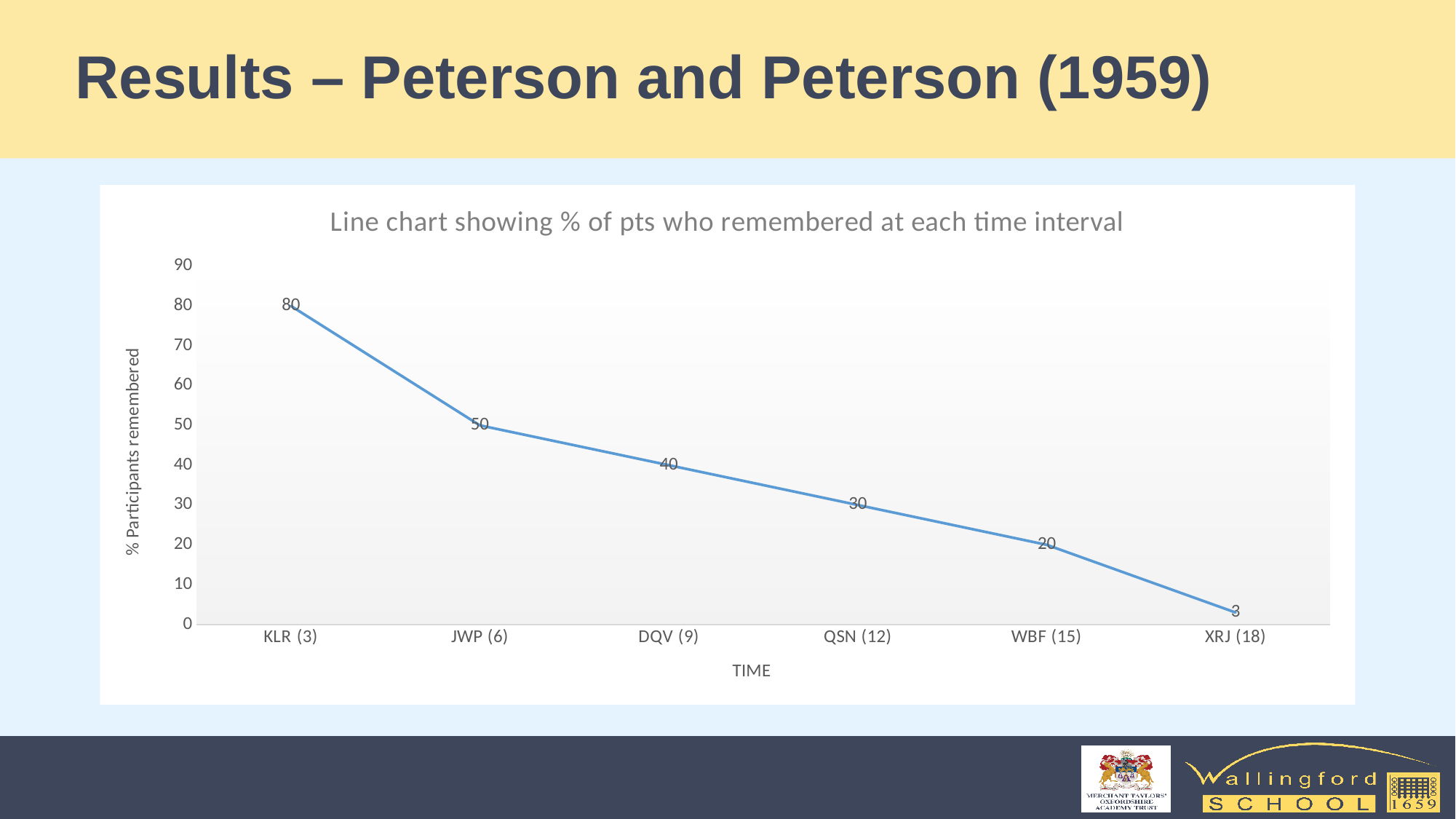
What is the difference between the values for WBF (15) and XRJ (18)? 17 What is the value for DQV (9)? 40 What is the value for KLR (3)? 80 What is the title of the chart? Line chart showing % of pts who remembered at each time interval What is the value for XRJ (18)? 3 Which time interval has the highest % of participants remembered? KLR (3) How many time intervals are plotted on the chart? 6 Which is larger, the value for QSN (12) or the value for WBF (15)? QSN (12) Do the values rise or fall along the x axis from KLR (3) to XRJ (18)? Fall What is the difference between the values for KLR (3) and JWP (6)? 30 Which time interval has the lowest % of participants remembered? XRJ (18) What kind of chart is shown on the slide? Line chart